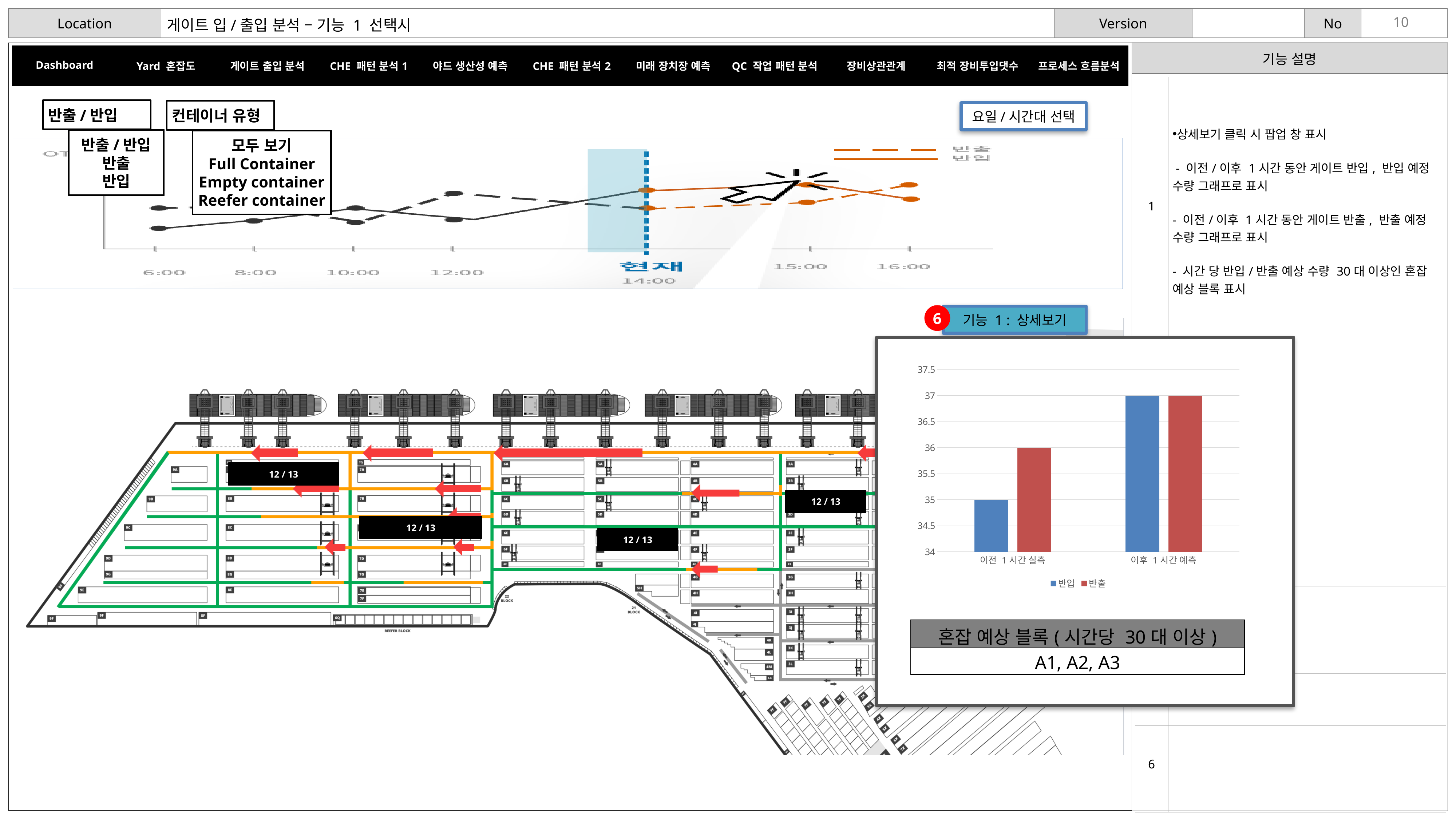
In the bar chart in the '기능 1 : 상세보기' popup, what is the 반출 value for '이후 1 시간 예측'? 37 What kind of chart is shown in the '기능 1 : 상세보기' popup on the right of the slide? bar chart In the bar chart in the '기능 1 : 상세보기' popup, does the 반입 value rise or fall from '이전 1 시간 실측' to '이후 1 시간 예측'? rise In the bar chart in the '기능 1 : 상세보기' popup, which is larger for '이전 1 시간 실측': 반입 or 반출? 반출 In the bar chart in the '기능 1 : 상세보기' popup, what is the 반입 value for '이후 1 시간 예측'? 37 In the bar chart in the '기능 1 : 상세보기' popup, how many series does the legend list? 2 In the bar chart in the '기능 1 : 상세보기' popup, what are the two legend entries? 반입, 반출 In the bar chart in the '기능 1 : 상세보기' popup, how many categories are shown on the x axis? 2 In the bar chart in the '기능 1 : 상세보기' popup, which colour represents the 반입 series? blue In the bar chart in the '기능 1 : 상세보기' popup, what is the difference between the 반입 values for '이후 1 시간 예측' and '이전 1 시간 실측'? 2 In the bar chart in the '기능 1 : 상세보기' popup, what is the 반입 value for '이전 1 시간 실측'? 35 In the bar chart in the '기능 1 : 상세보기' popup, what is the 반출 value for '이전 1 시간 실측'? 36